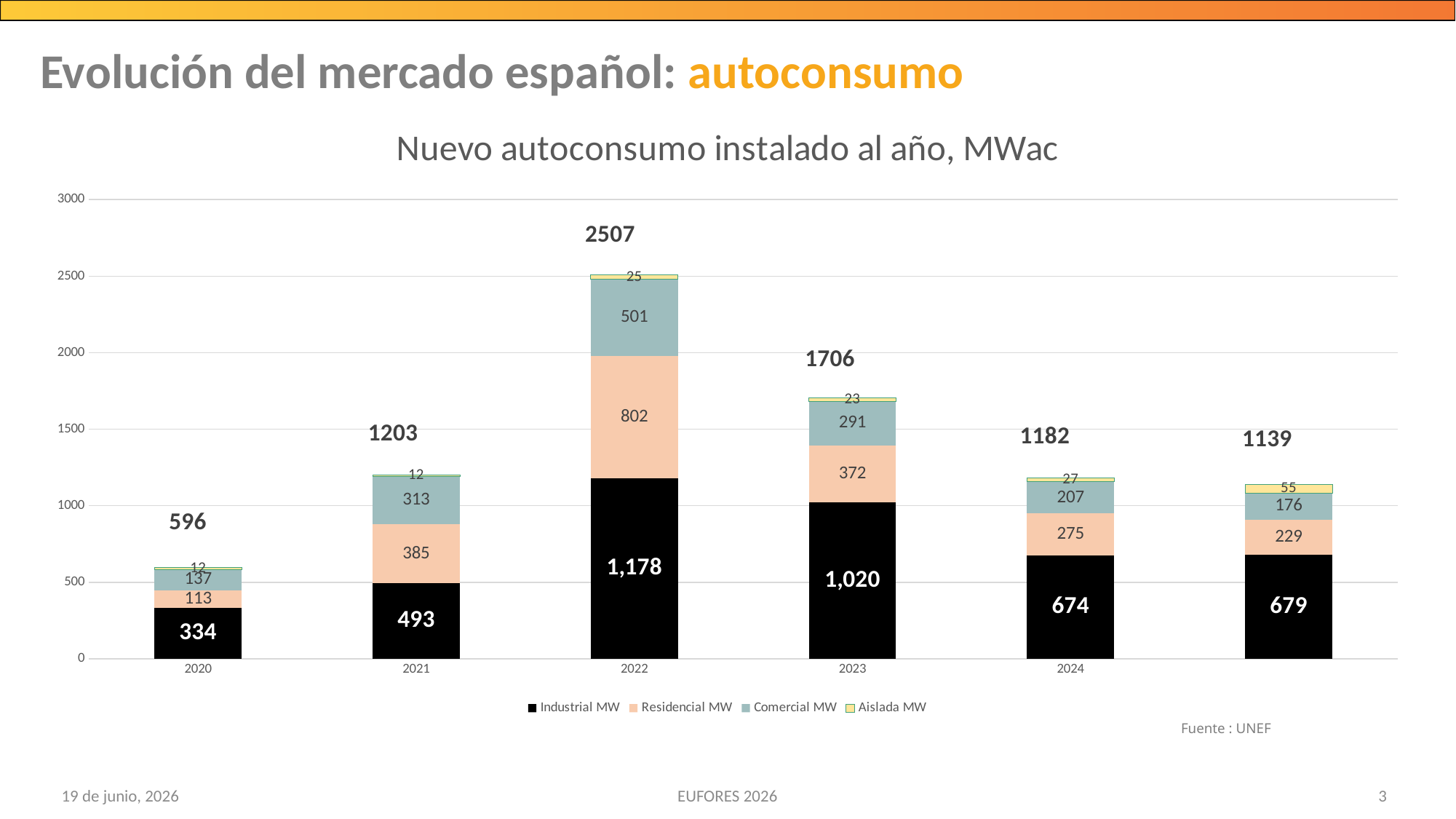
What is the Industrial MW value for 2022? 1,178 What is the Comercial MW value for 2021? 313 What kind of chart is shown on the slide? Stacked bar chart What is the Residencial MW value for 2023? 372 What is the difference between the Industrial MW values for 2022 and 2023? 158 How many years are shown on the x axis? 5 How many series does the legend list? 4 Which year has the lowest total new self-consumption installed? 2020 What is the total of the stacked bar for 2023? 1706 Which year has the highest total new self-consumption installed? 2022